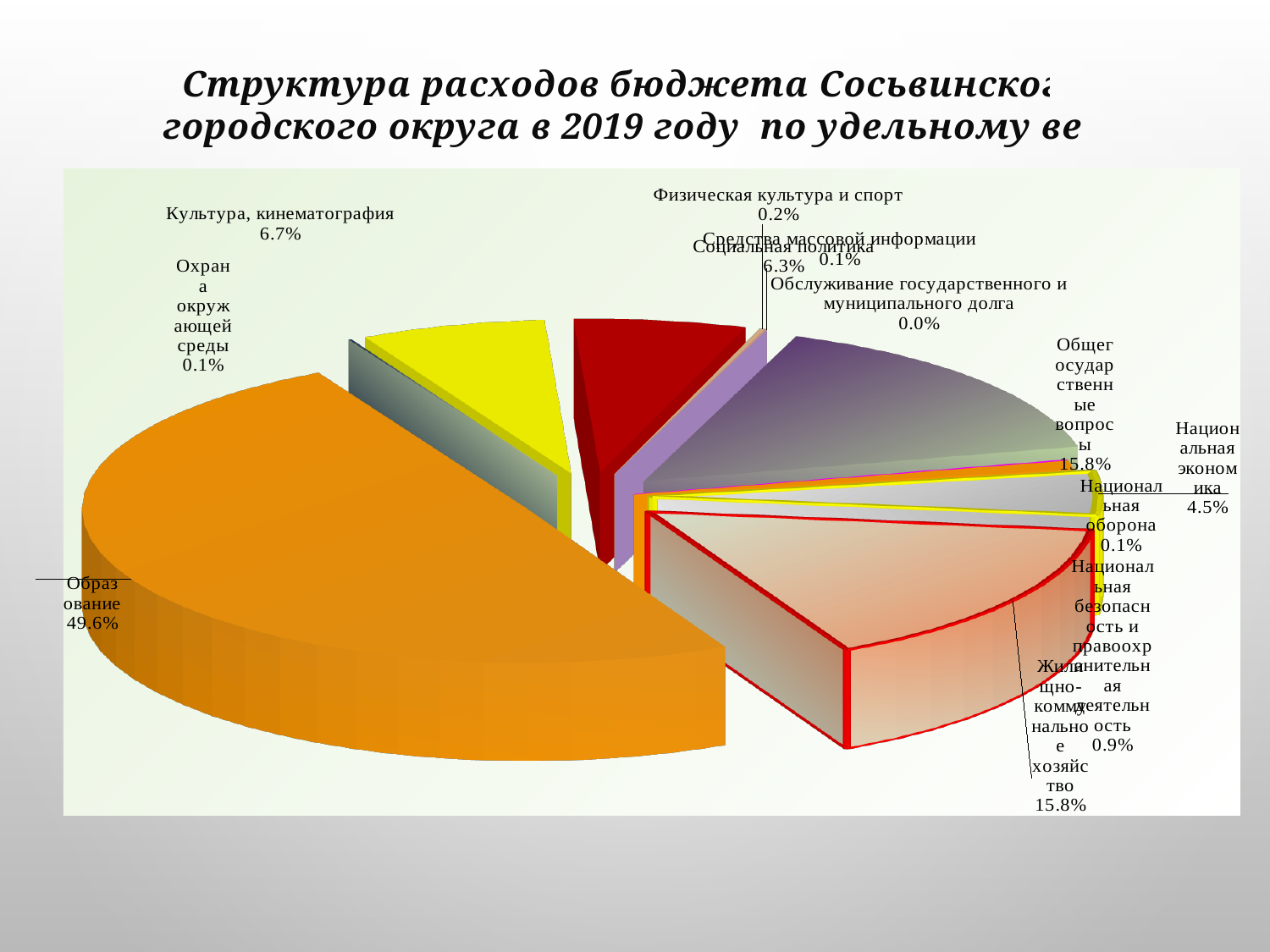
What is the value shown for Национальная экономика? 4.5% How many categories are shown in the pie chart? 12 What is the difference between the shares of Образование and Общегосударственные вопросы? 33.8% What is the value shown for Общегосударственные вопросы? 15.8% What is the value shown for Социальная политика? 6.3% Which is larger, the share for Культура, кинематография or the share for Национальная экономика? Культура, кинематография What share of budget expenditure does Образование account for? 49.6% Which category has the largest share of the pie? Образование What is the value shown for Жилищно-коммунальное хозяйство? 15.8% Which category has the smallest share of the pie? Обслуживание государственного и муниципального долга What kind of chart is shown on the slide? pie chart What is the value shown for Культура, кинематография? 6.7%